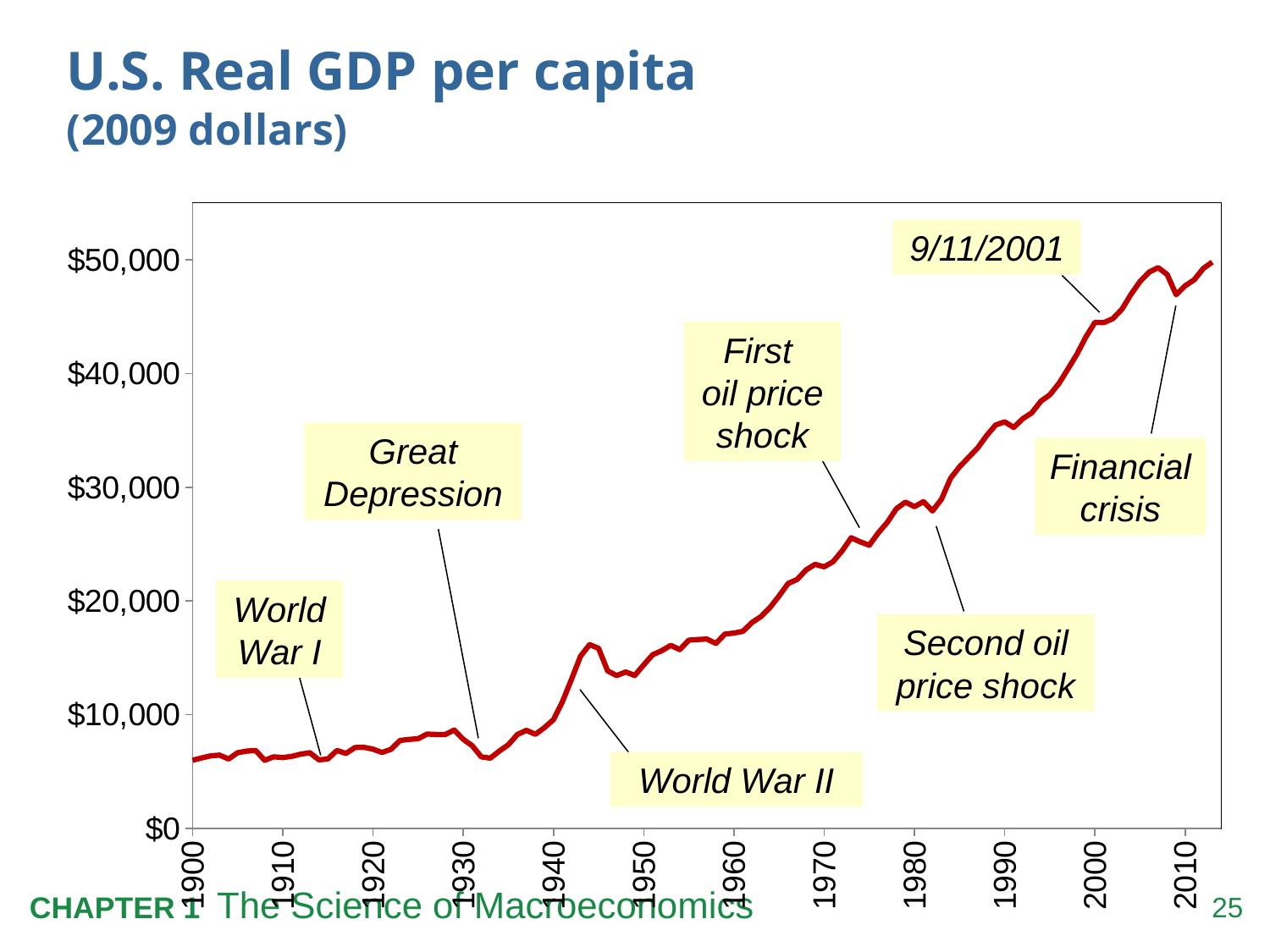
Is the value for 2000 greater or less than $40,000? greater In what dollars is U.S. real GDP per capita measured, according to the chart title? 2009 dollars Which is larger, the value for 1950 or the value for 1930? 1950 Is the value for 1990 greater or less than $30,000? greater What kind of chart is shown on the slide? line chart How many year labels are shown on the x axis? 12 Is the value for 1900 greater or less than $10,000? less Overall, does U.S. real GDP per capita rise or fall from 1900 to the end of the series? rise